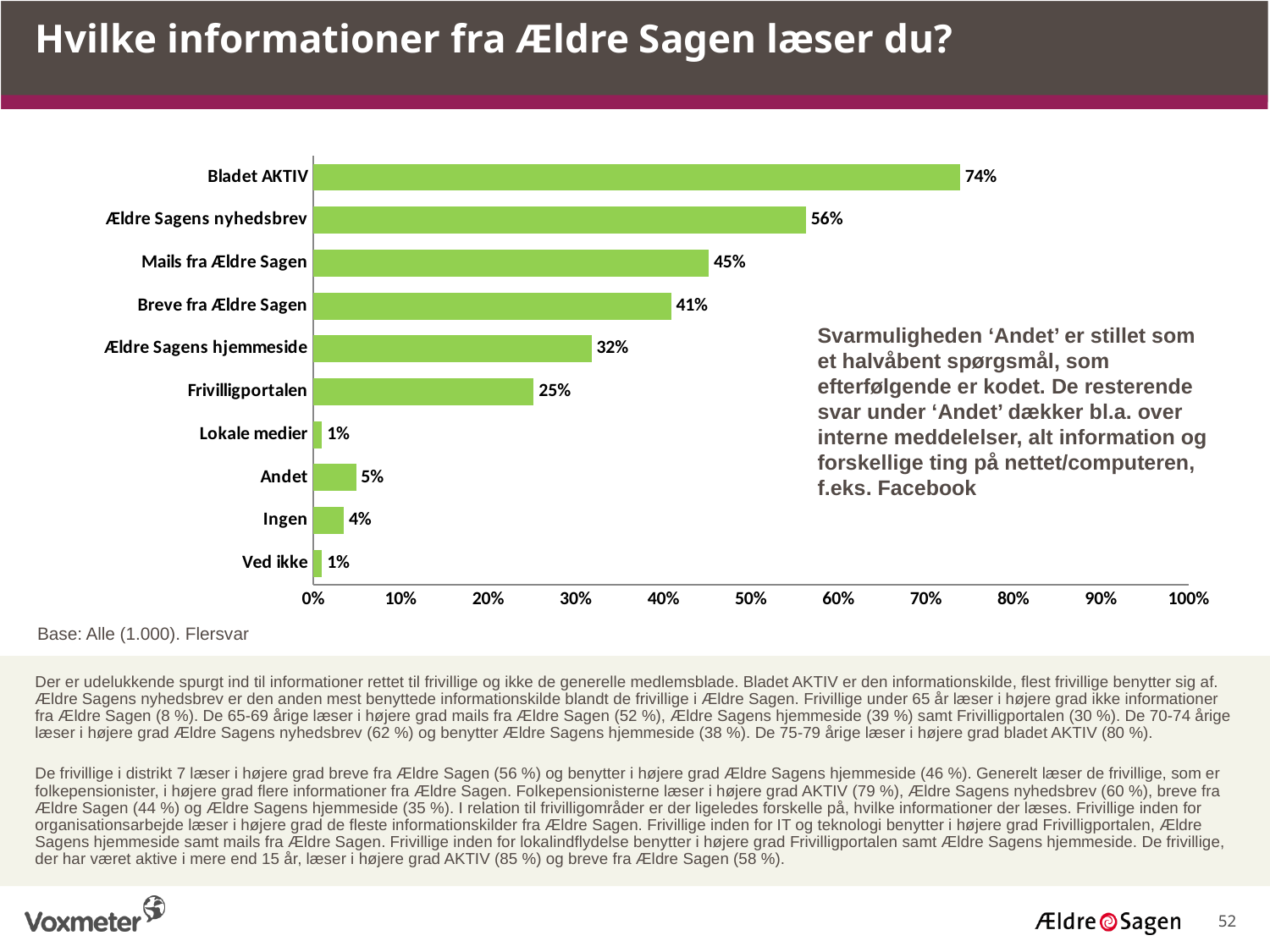
What is the title of the slide? Hvilke informationer fra Ældre Sagen læser du? What is the value for Frivilligportalen? 25% Which category has the highest value? Bladet AKTIV Which is larger, Ældre Sagens hjemmeside or Frivilligportalen? Ældre Sagens hjemmeside What is the value for Bladet AKTIV? 74% Is the value for Ældre Sagens nyhedsbrev greater or less than 50%? greater What is the value for Ingen? 4% How many categories are shown in the chart? 10 What is the value for Ældre Sagens nyhedsbrev? 56% What kind of chart is shown on the slide? Bar chart What is the difference between Mails fra Ældre Sagen and Breve fra Ældre Sagen? 4% What is the difference between Bladet AKTIV and Ældre Sagens nyhedsbrev? 18%